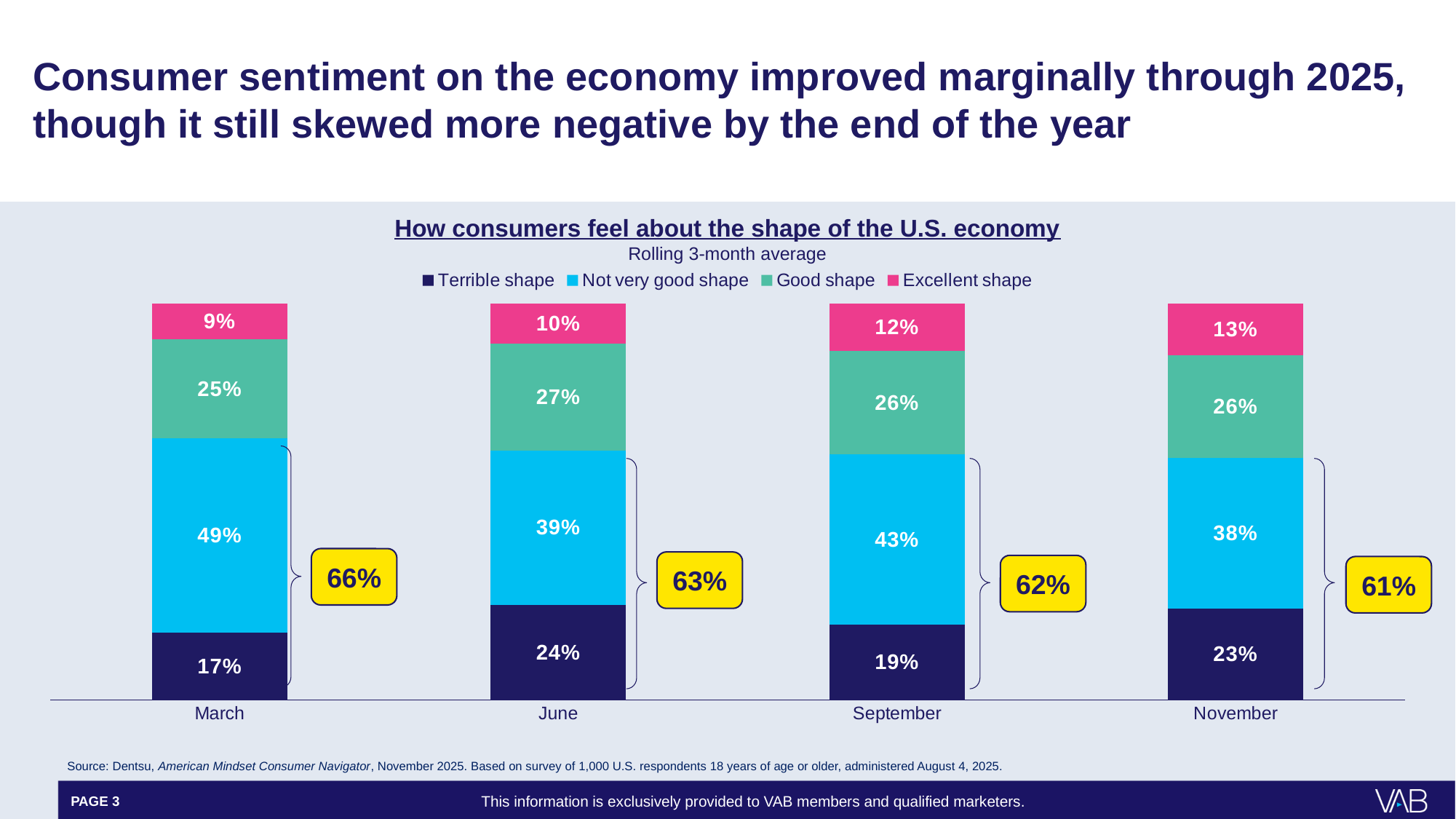
What is the difference between the Not very good shape values for March and November? 11% Do the Excellent shape values rise or fall from March to November? Rise What kind of chart is shown on the slide? Stacked bar chart In which month is the Excellent shape value highest? November What is the value for Excellent shape in November? 13% Which is larger, the Good shape value in June or in September? June What is the value for Not very good shape in March? 49% In which month is the Terrible shape value lowest? March What is the combined share of Terrible shape and Not very good shape in September, as shown in the callout? 62% How many series does the legend list? 4 What is the value for Terrible shape in June? 24% How many months are shown along the x axis? 4